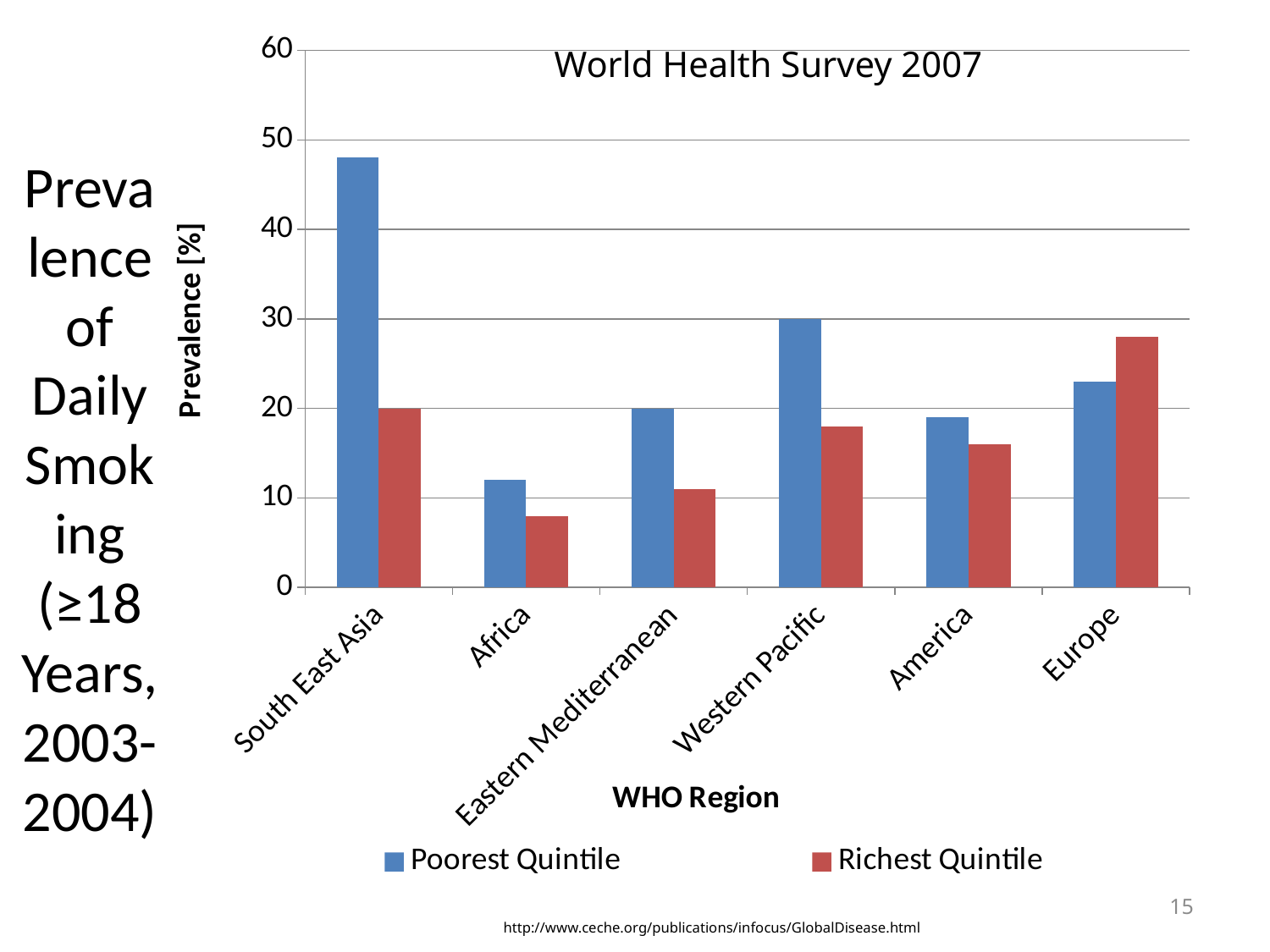
How many series does the chart's legend list? 2 Which WHO region has the highest Richest Quintile prevalence? Europe Which WHO region has the lowest Richest Quintile prevalence? Africa Which WHO region has the highest Poorest Quintile prevalence? South East Asia What is the label of the x axis? WHO Region Is the Poorest Quintile value for South East Asia greater or less than 40? greater What type of chart is shown on the slide? Bar chart How many WHO regions are shown on the x axis of the chart? 6 What is the Poorest Quintile prevalence for Western Pacific? 30 What is the Richest Quintile prevalence for South East Asia? 20 In Europe, which is larger: the Poorest Quintile or the Richest Quintile prevalence? Richest Quintile What is the title of the chart? World Health Survey 2007